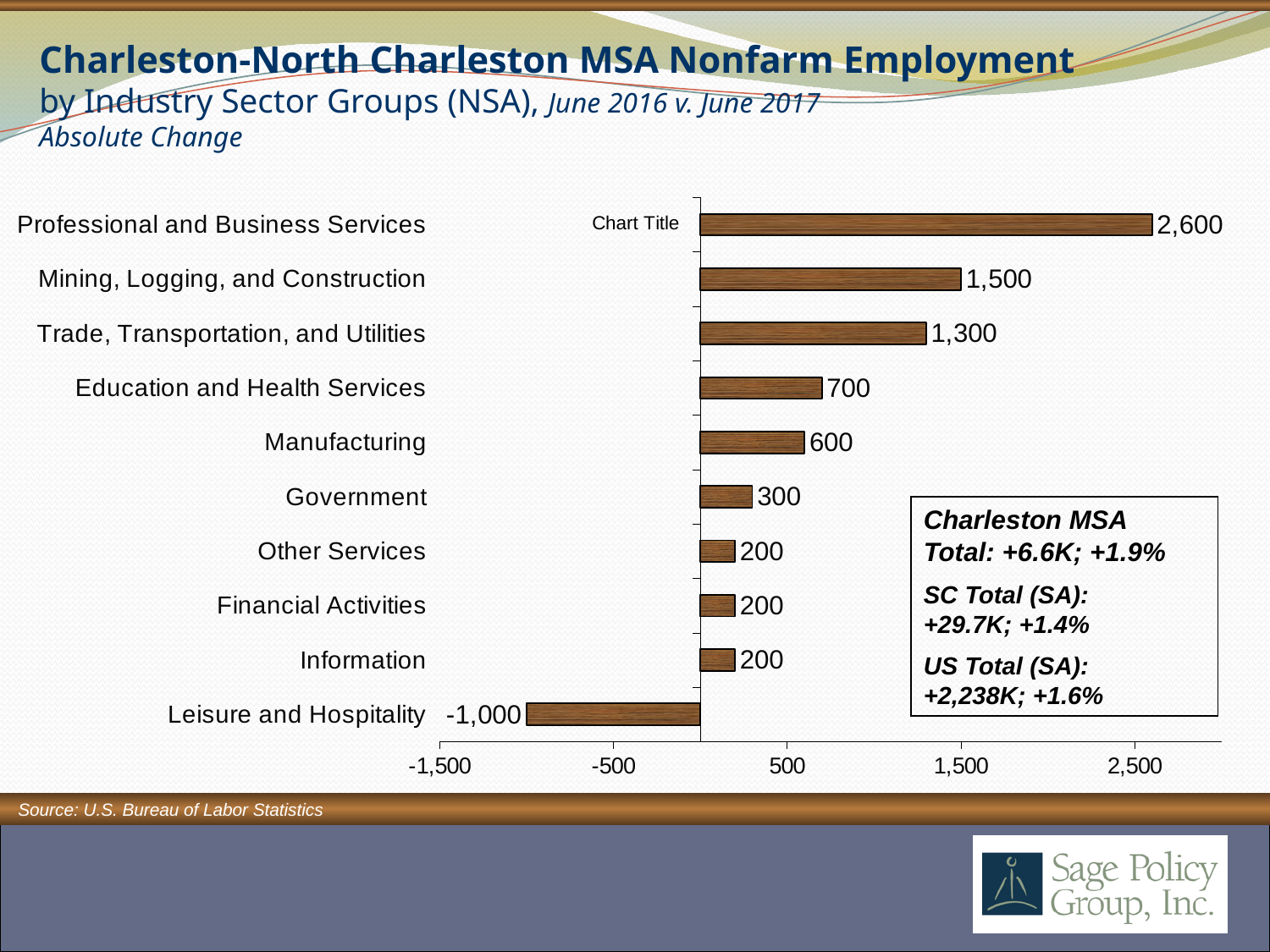
What is the absolute change in employment for Leisure and Hospitality? -1,000 What is the absolute change in employment for Manufacturing? 600 What kind of chart is shown on the slide? Bar chart According to the text box on the chart, what is the Charleston MSA total change? +6.6K; +1.9% How many industry sector groups are shown in the chart? 10 What is the absolute change in employment for Professional and Business Services? 2,600 What is the difference between the absolute change for Mining, Logging, and Construction and for Trade, Transportation, and Utilities? 200 What is the absolute change in employment for Government? 300 How many industry sector groups show an absolute change of 200? 3 Which industry sector group has the highest absolute change? Professional and Business Services Which has a larger absolute change, Education and Health Services or Manufacturing? Education and Health Services Which industry sector group has the lowest absolute change? Leisure and Hospitality